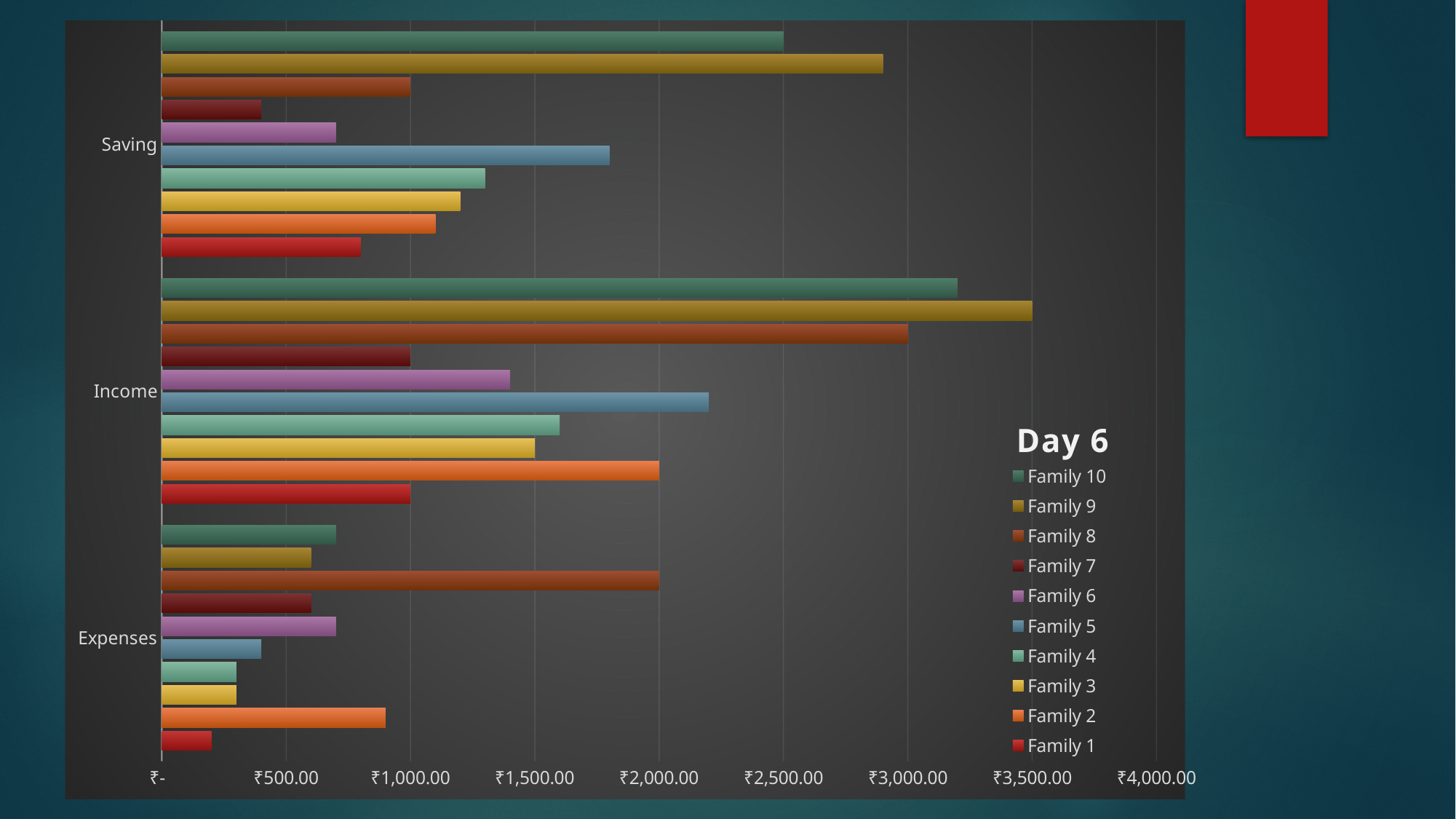
What kind of chart is shown on the slide? bar chart Is the Expenses value for Family 4 greater or less than ₹500.00? less Which is larger: the Income of Family 5 or the Income of Family 2? Family 5 Is the Saving value for Family 5 greater or less than ₹1,500.00? greater What is the title of the chart? Day 6 Which family has the highest Income? Family 9 How many series does the legend list? 10 Which family has the highest Expenses? Family 8 Which is larger: the Saving of Family 9 or the Saving of Family 10? Family 9 Which family has the lowest Expenses? Family 1 How many categories are shown on the vertical axis? 3 Which family has the lowest Saving? Family 7